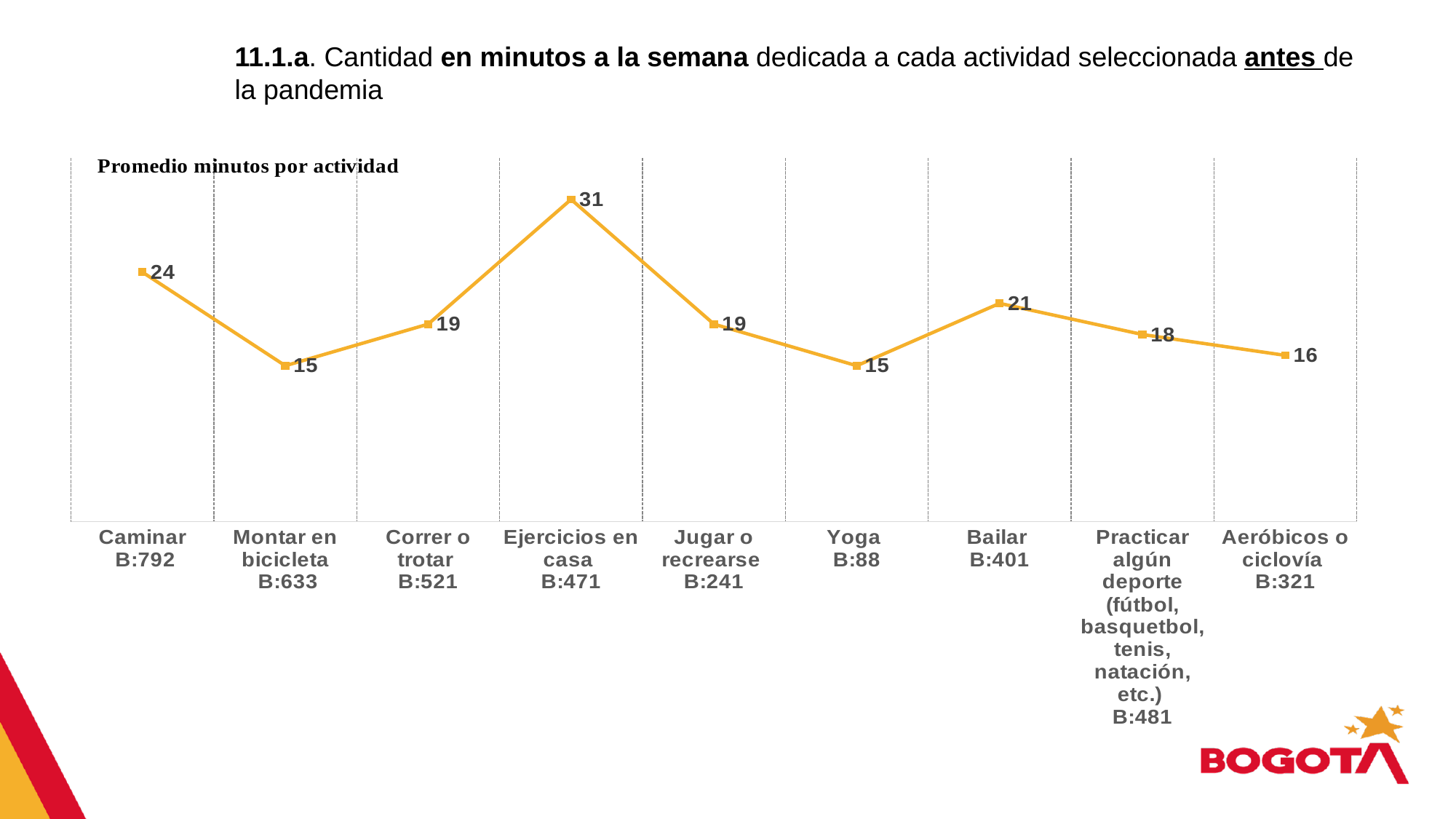
What is the value shown for Bailar? 21 What is the value shown for Caminar? 24 What is the difference between the values for Ejercicios en casa and Yoga? 16 What is the difference between the values for Caminar and Montar en bicicleta? 9 What type of chart is shown on the slide? Line chart How many activities are plotted on the chart? 9 What is the average minutes per activity value for Ejercicios en casa? 31 Which has a higher value, Bailar or Practicar algún deporte? Bailar What is the lowest value plotted on the chart? 15 What is the label shown at the top left inside the chart area? Promedio minutos por actividad What is the value shown for Aeróbicos o ciclovía? 16 Which activity has the highest average minutes? Ejercicios en casa